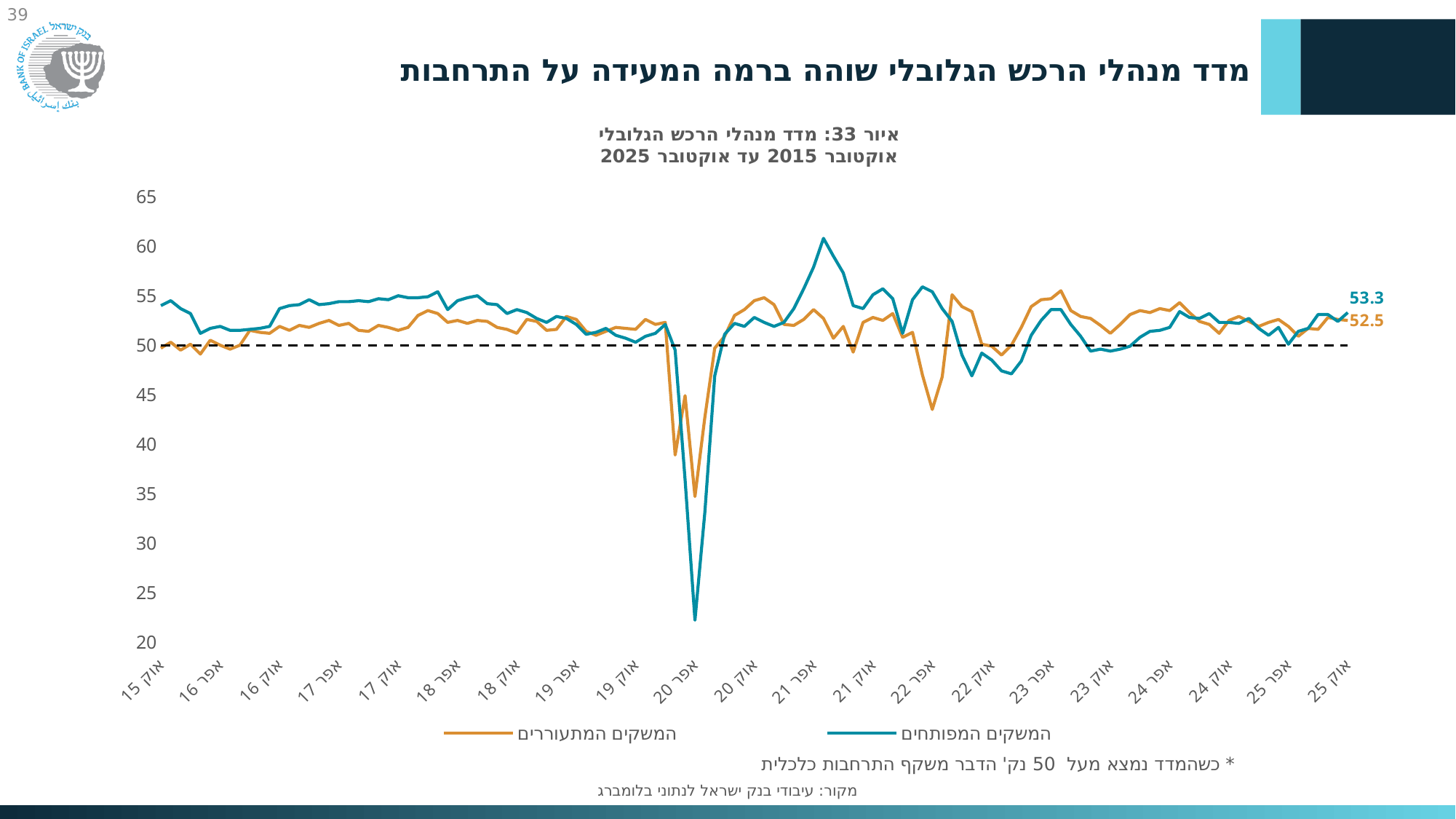
Which colour represents the emerging economies (המשקים המתעוררים) series? Orange Which series falls to the lowest value during the 2020 dip? Developed economies (המשקים המפותחים) What is the latest value (October 2025) shown for the developed economies (המשקים המפותחים) series? 53.3 Is the lowest point of the developed economies series (around 2020) greater or less than 25? less What is the latest value (October 2025) shown for the emerging economies (המשקים המתעוררים) series? 52.5 Is the lowest point of the emerging economies series (around 2020) greater or less than 40? less At the end of the chart (October 2025), which series has the higher value: developed economies or emerging economies? Developed economies (המשקים המפותחים) What is the difference between the latest values of the developed economies (53.3) and emerging economies (52.5) series? 0.8 What type of chart is shown on the slide? Line chart At what level is the dashed horizontal reference line drawn? 50 Is the peak of the developed economies series in 2021 greater or less than 55? greater How many series does the legend list? 2